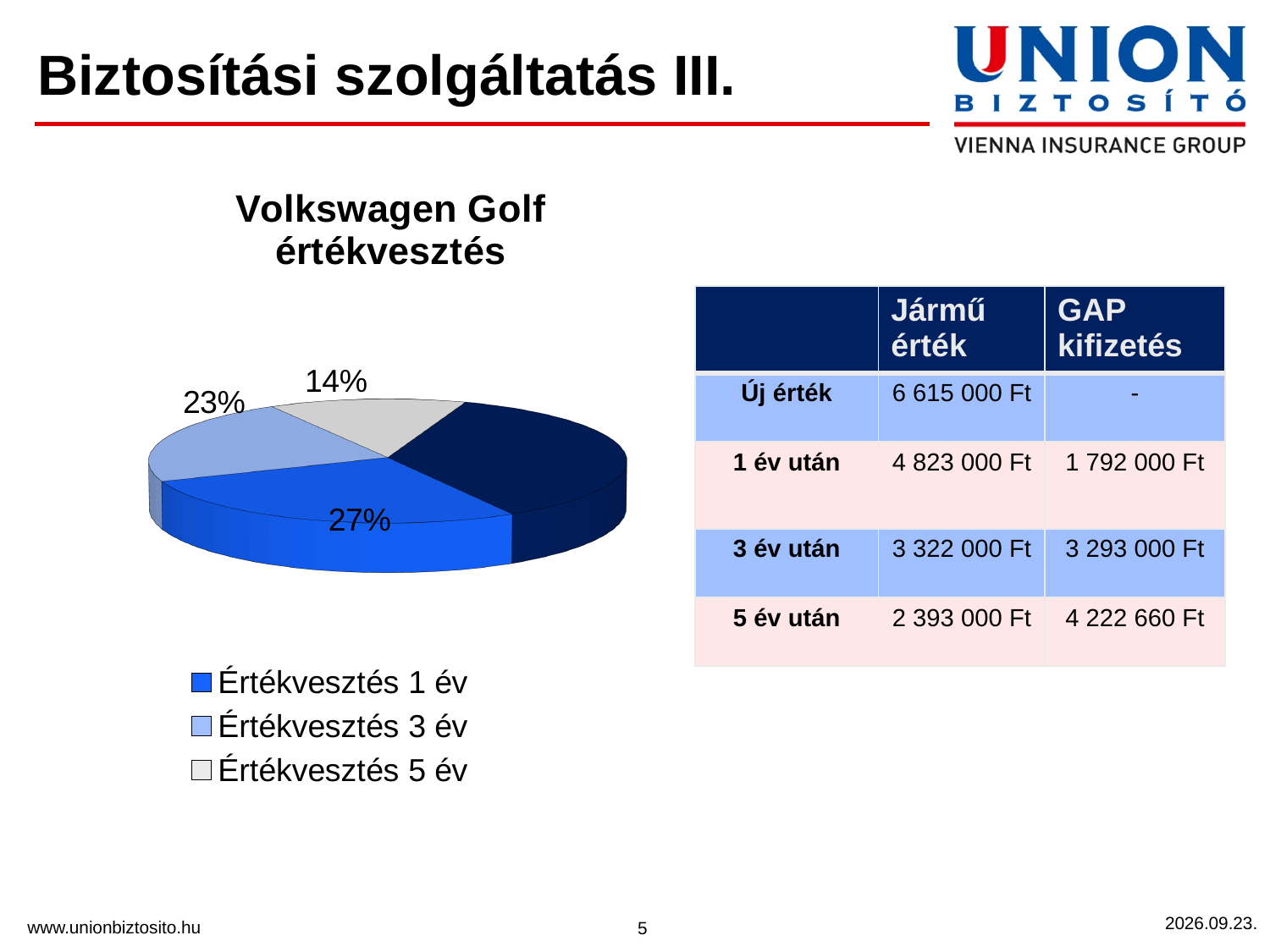
What is the title of the pie chart? Volkswagen Golf értékvesztés What kind of chart is shown on the slide? Pie chart Which of the legend entries has the largest labelled share in the pie chart? Értékvesztés 1 év What percentage is shown for Értékvesztés 5 év in the pie chart? 14% How many entries does the legend of the pie chart list? 3 What colour represents Értékvesztés 1 év in the pie chart? Blue What percentage is shown for Értékvesztés 3 év in the pie chart? 23% What percentage is shown for Értékvesztés 1 év in the Volkswagen Golf értékvesztés pie chart? 27% Which of the legend entries has the smallest labelled share in the pie chart? Értékvesztés 5 év What is the difference in percentage points between Értékvesztés 3 év and Értékvesztés 5 év? 9 percentage points Which is larger in the pie chart: Értékvesztés 3 év or Értékvesztés 5 év? Értékvesztés 3 év What is the difference in percentage points between Értékvesztés 1 év and Értékvesztés 3 év? 4 percentage points